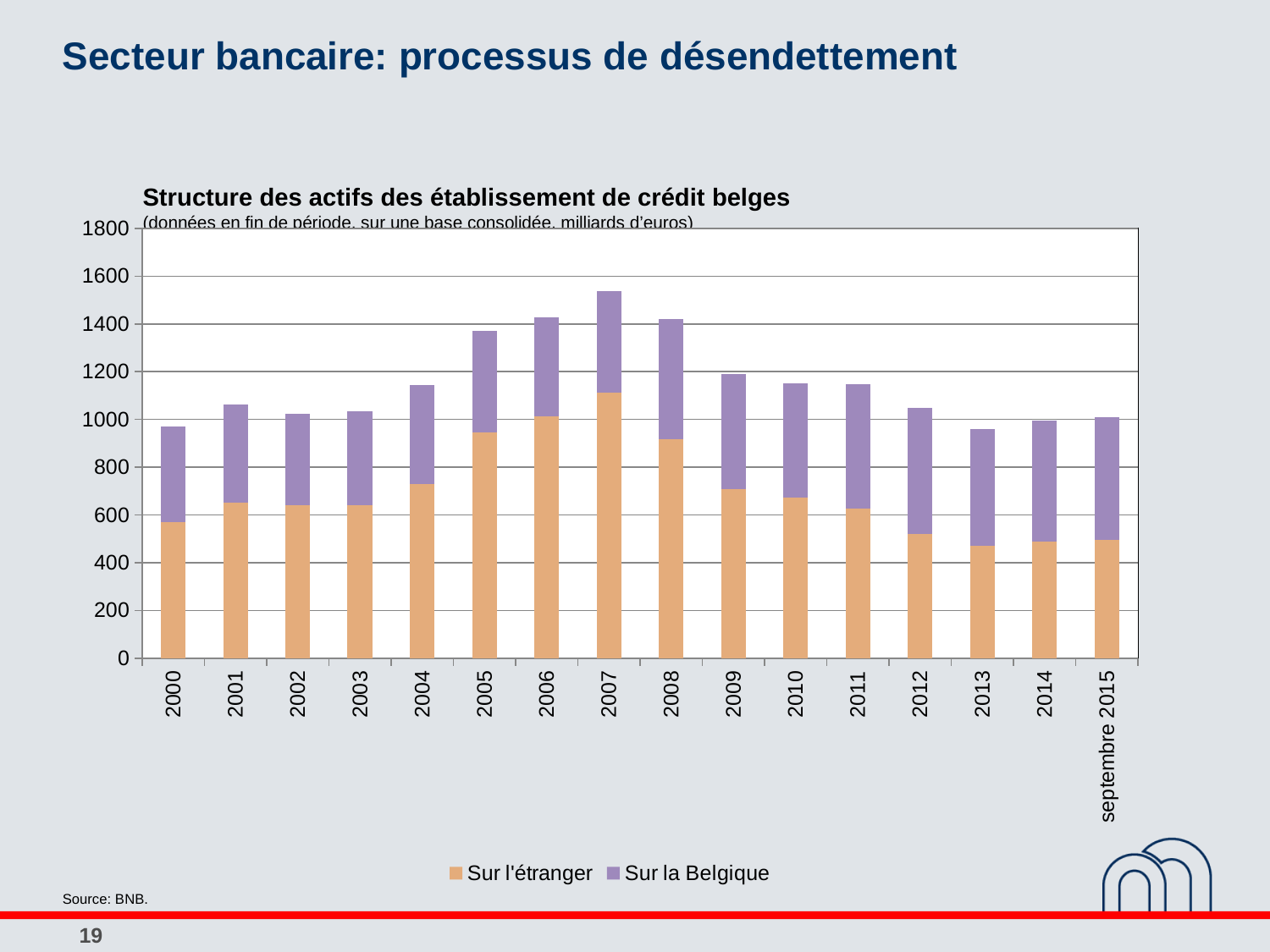
What kind of chart is shown on the slide? stacked bar chart Which has the larger total, 2007 or 2008? 2007 How many periods are shown along the x axis? 16 Which year has the highest total assets? 2007 What are the two series named in the legend? Sur l'étranger and Sur la Belgique Is the 'Sur l'étranger' value for 2013 greater or less than 600? less How many series does the legend list? 2 Is the total for 2007 greater or less than 1400? greater Is the total for 2013 greater or less than 1000? less Do the total assets rise or fall from 2007 to 2013? fall What is the title of the chart? Structure des actifs des établissement de crédit belges